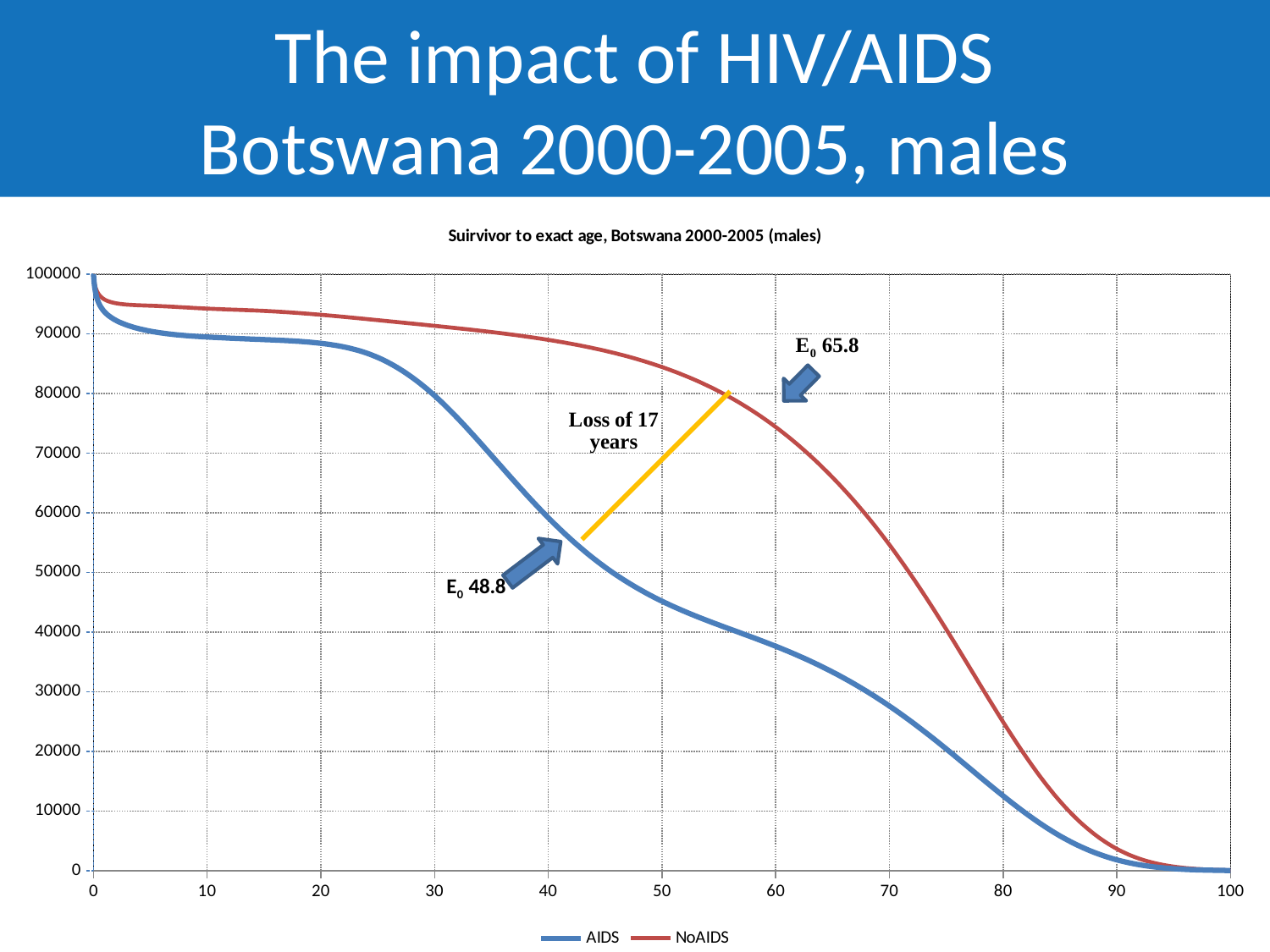
What life expectancy at birth (E0) is annotated for the NoAIDS curve? 65.8 Is the NoAIDS survivor value at age 20 greater or less than 90000? greater What is the title of the chart? Suirvivor to exact age, Botswana 2000-2005 (males) Do the survivor values rise or fall as age increases along the x axis? fall Is the AIDS survivor value at age 60 greater or less than 40000? less Is the AIDS survivor value at age 80 greater or less than 20000? less At age 50, which series has the higher survivor value, AIDS or NoAIDS? NoAIDS What kind of chart is shown on the slide? line chart How many series does the legend list? 2 What are the two series named in the legend? AIDS and NoAIDS